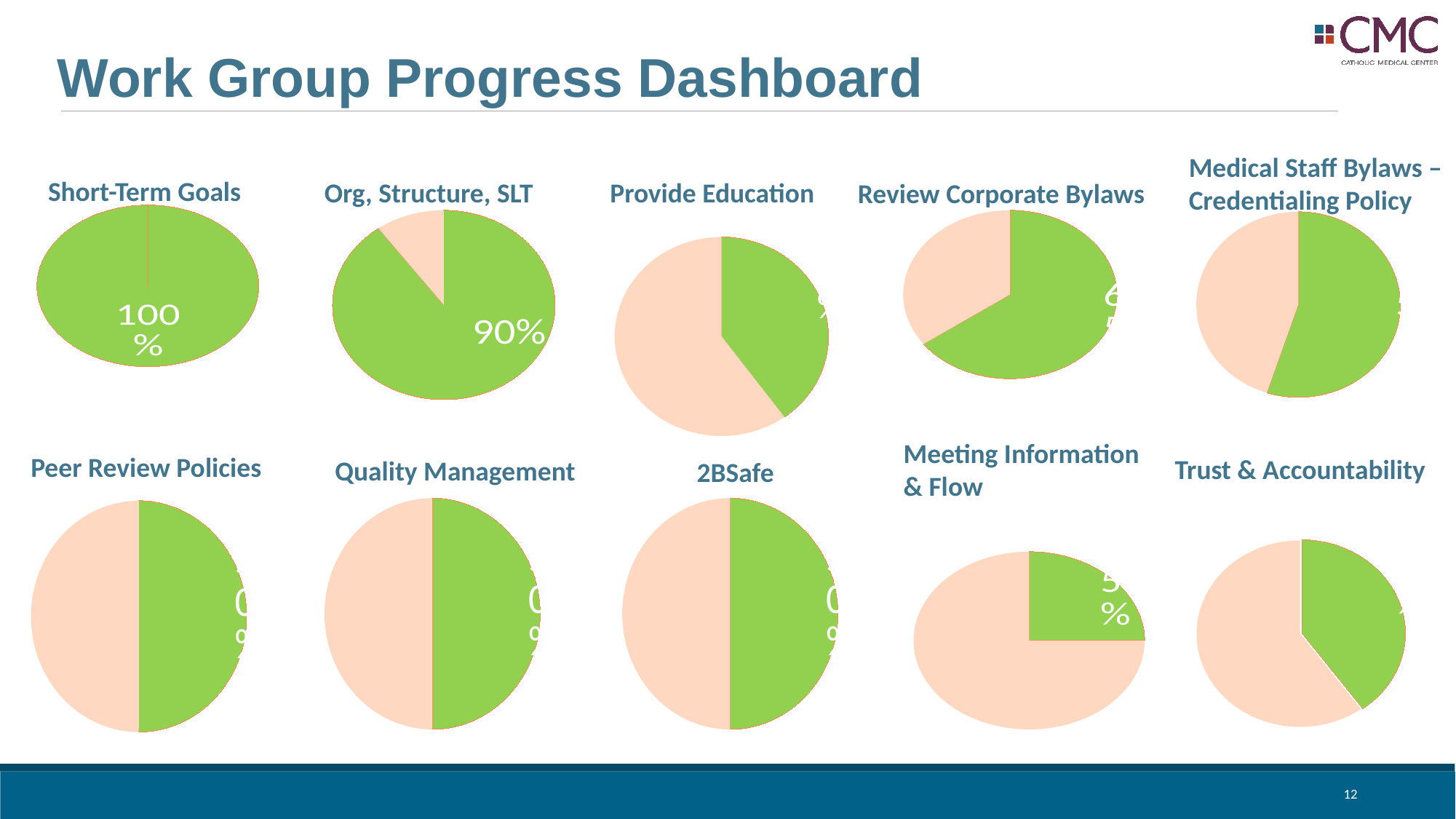
On the Review Corporate Bylaws chart, is the green share greater or less than 50%? greater What kind of charts are shown on the slide? Pie charts What value is shown on the Short-Term Goals pie chart? 100% What is the title of the slide containing the pie charts? Work Group Progress Dashboard How many pie charts are on the slide? 10 On the Trust & Accountability chart, is the green share greater or less than 50%? less Which work group's pie chart shows the largest green (completed) share? Short-Term Goals Which is larger, the value on the Short-Term Goals chart or the value on the Org, Structure, SLT chart? Short-Term Goals On the Meeting Information & Flow chart, is the green share greater or less than 50%? less Which work group's pie chart shows the smallest green (completed) share? Meeting Information & Flow What value is shown on the Org, Structure, SLT pie chart? 90% What is the difference between the value on the Short-Term Goals chart and the value on the Org, Structure, SLT chart? 10%